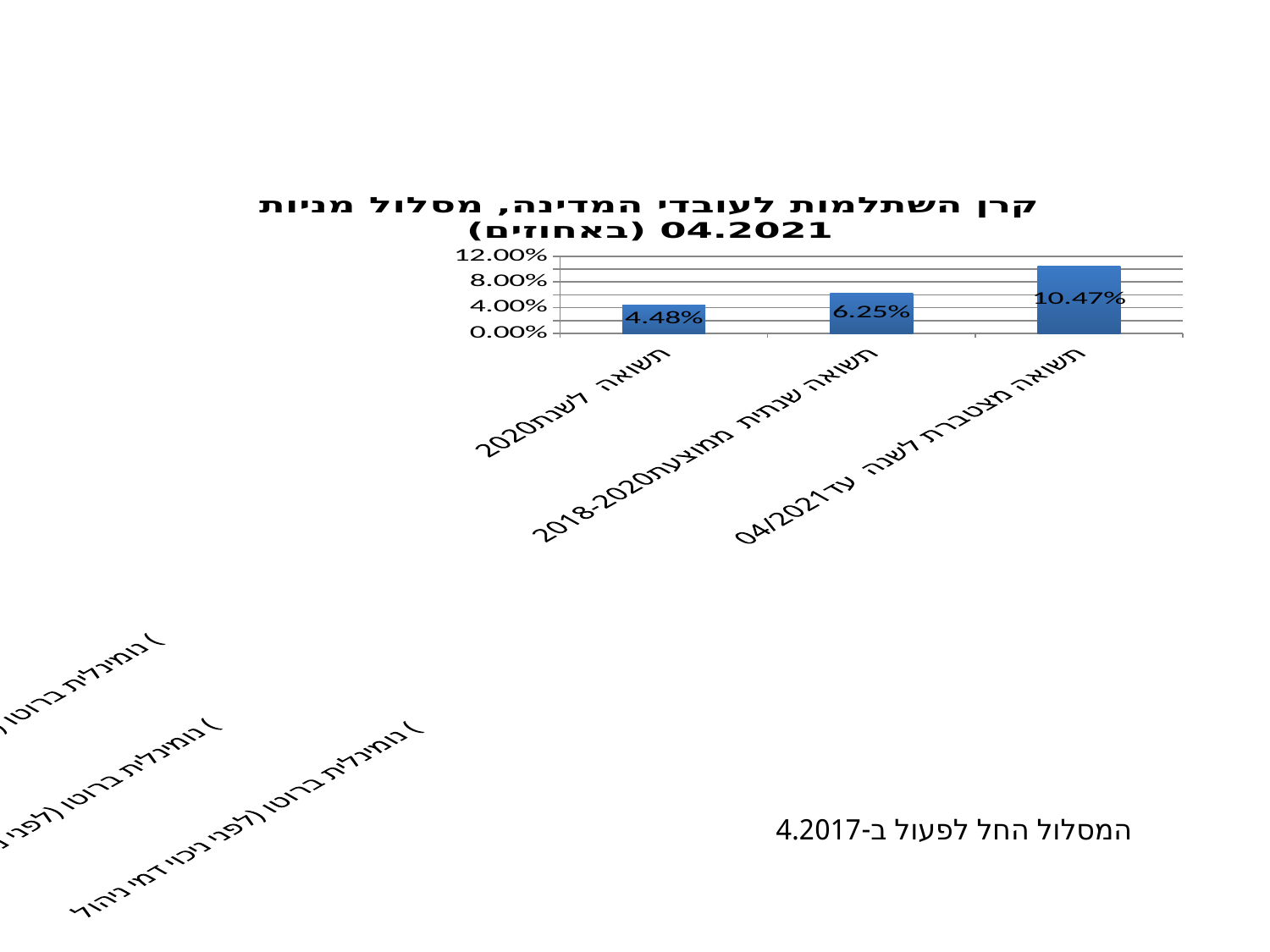
What is the value for "תשואה מצטברת לשנה עד 04/2021"? 10.47% What is the difference between the value for "תשואה שנתית ממוצעת 2018-2020" and the value for "תשואה לשנת 2020"? 1.77% What is the difference between the value for "תשואה מצטברת לשנה עד 04/2021" and the value for "תשואה לשנת 2020"? 5.99% Which category has the lowest value? תשואה לשנת 2020 Is the value for "תשואה מצטברת לשנה עד 04/2021" greater or less than 8.00%? greater What is the value for "תשואה שנתית ממוצעת 2018-2020"? 6.25% How many categories are shown in the chart? 3 Do the values rise or fall from left to right along the x axis? rise Which is larger: the value for "תשואה שנתית ממוצעת 2018-2020" or the value for "תשואה לשנת 2020"? תשואה שנתית ממוצעת 2018-2020 What is the value for "תשואה לשנת 2020"? 4.48% Which category has the highest value? תשואה מצטברת לשנה עד 04/2021 What kind of chart is shown on the slide? bar chart